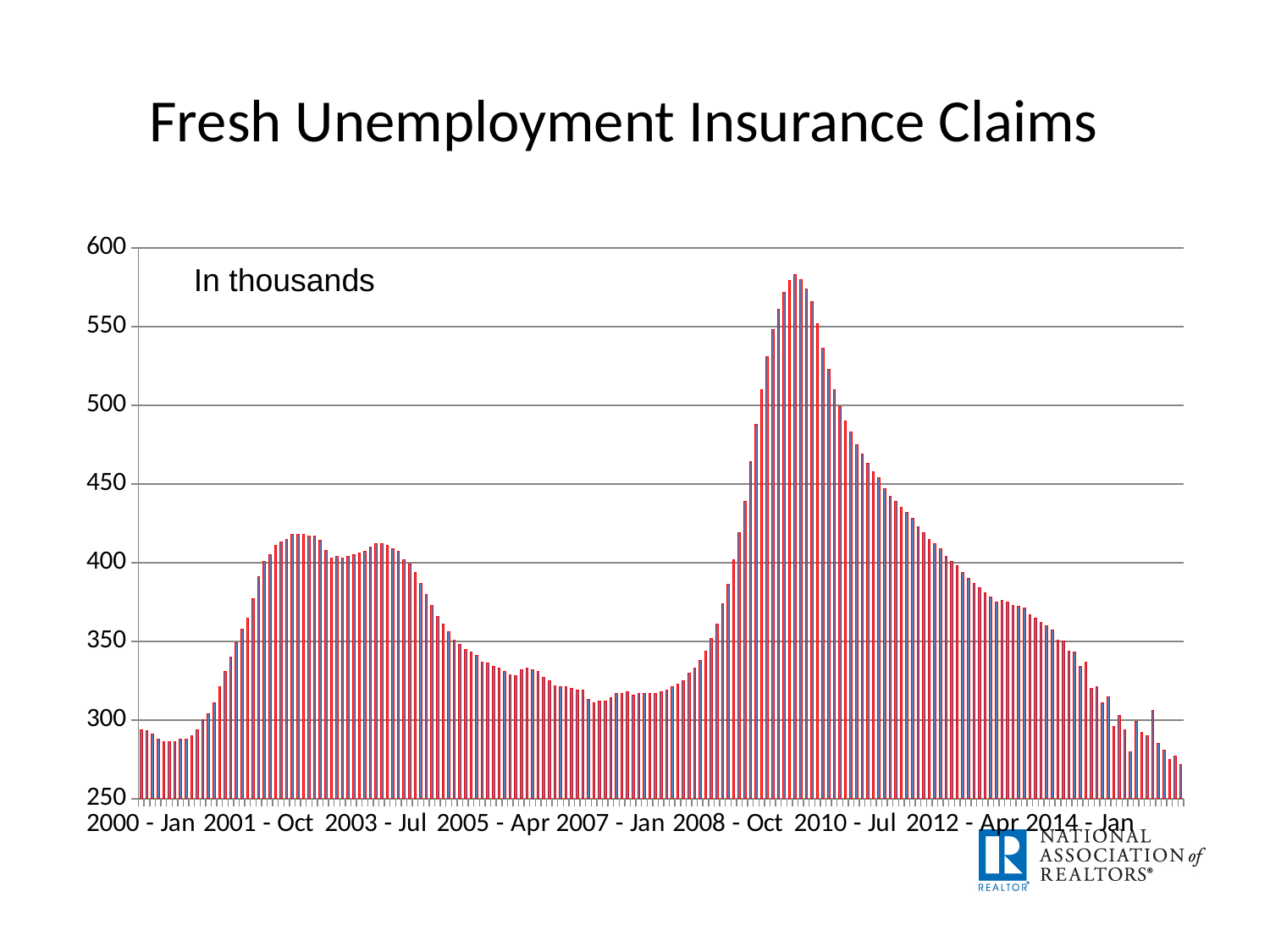
Do the values rise or fall between 2007 - Jan and the peak around 2010? rise Which is larger, the value at 2001 - Oct or the value at 2007 - Jan? 2001 - Oct Between which two x-axis labels does the peak of the chart occur? 2008 - Oct and 2010 - Jul What is the title of the chart? Fresh Unemployment Insurance Claims Is the value at 2010 - Jul greater or less than 450? greater Do the values rise or fall between 2010 - Jul and 2014 - Jan? fall Is the value at 2007 - Jan greater or less than 350? less In what units are the values plotted, according to the note inside the chart? In thousands What kind of chart is shown on the slide? bar chart Is the highest value on the chart greater or less than 550? greater